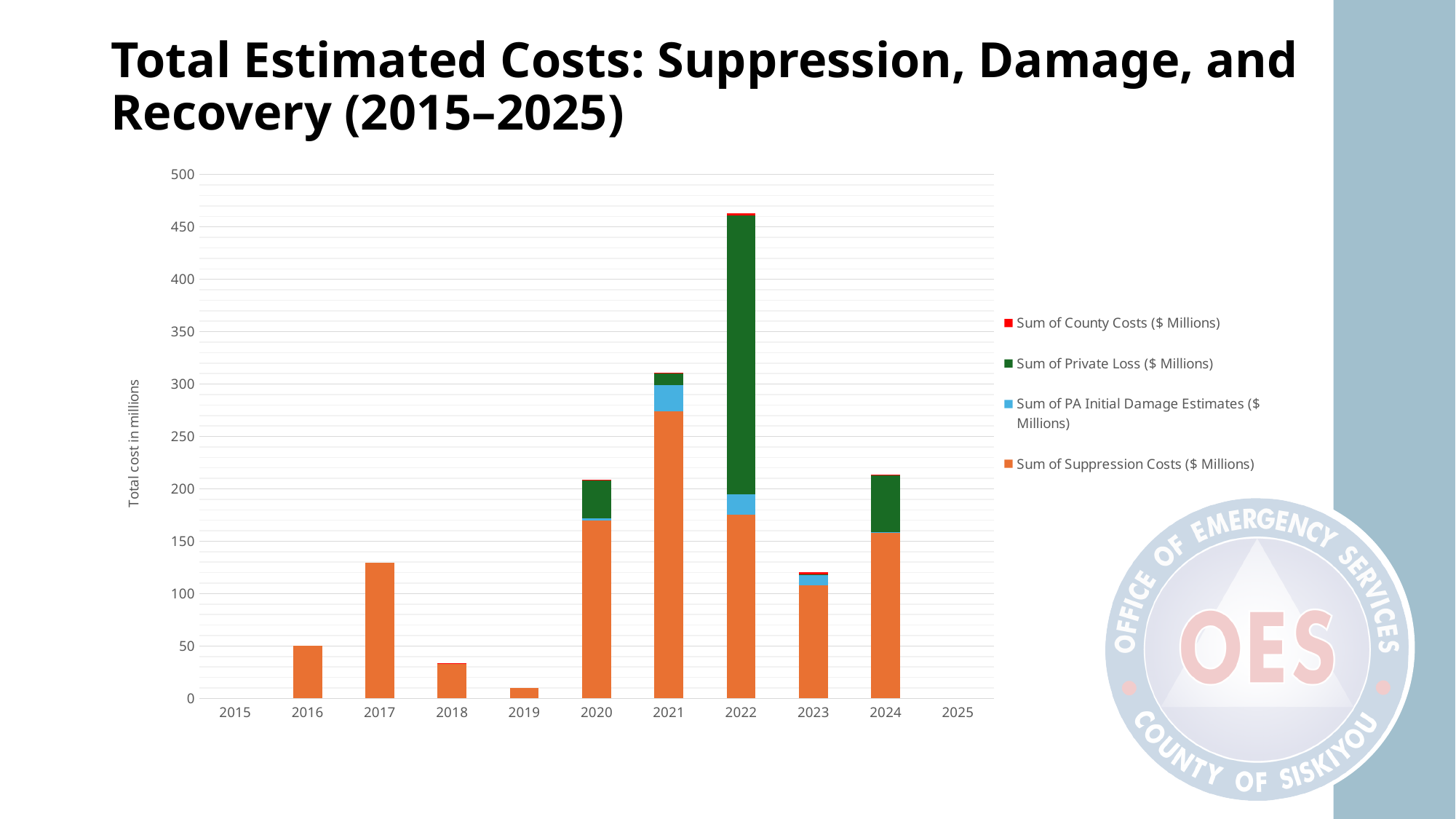
What kind of chart is shown on the slide? Stacked bar chart Is the total bar for 2022 greater or less than 450? greater What is the title of the vertical axis? Total cost in millions Is the total bar for 2018 greater or less than 50? less Which year has the larger total bar, 2021 or 2024? 2021 Which year has the highest total estimated cost? 2022 Which year has the larger total bar, 2016 or 2018? 2016 Is the total bar for 2021 greater or less than 300? greater How many series does the legend list? 4 How many years are shown on the x axis? 11 Among the years with a visible bar, which year has the lowest total estimated cost? 2019